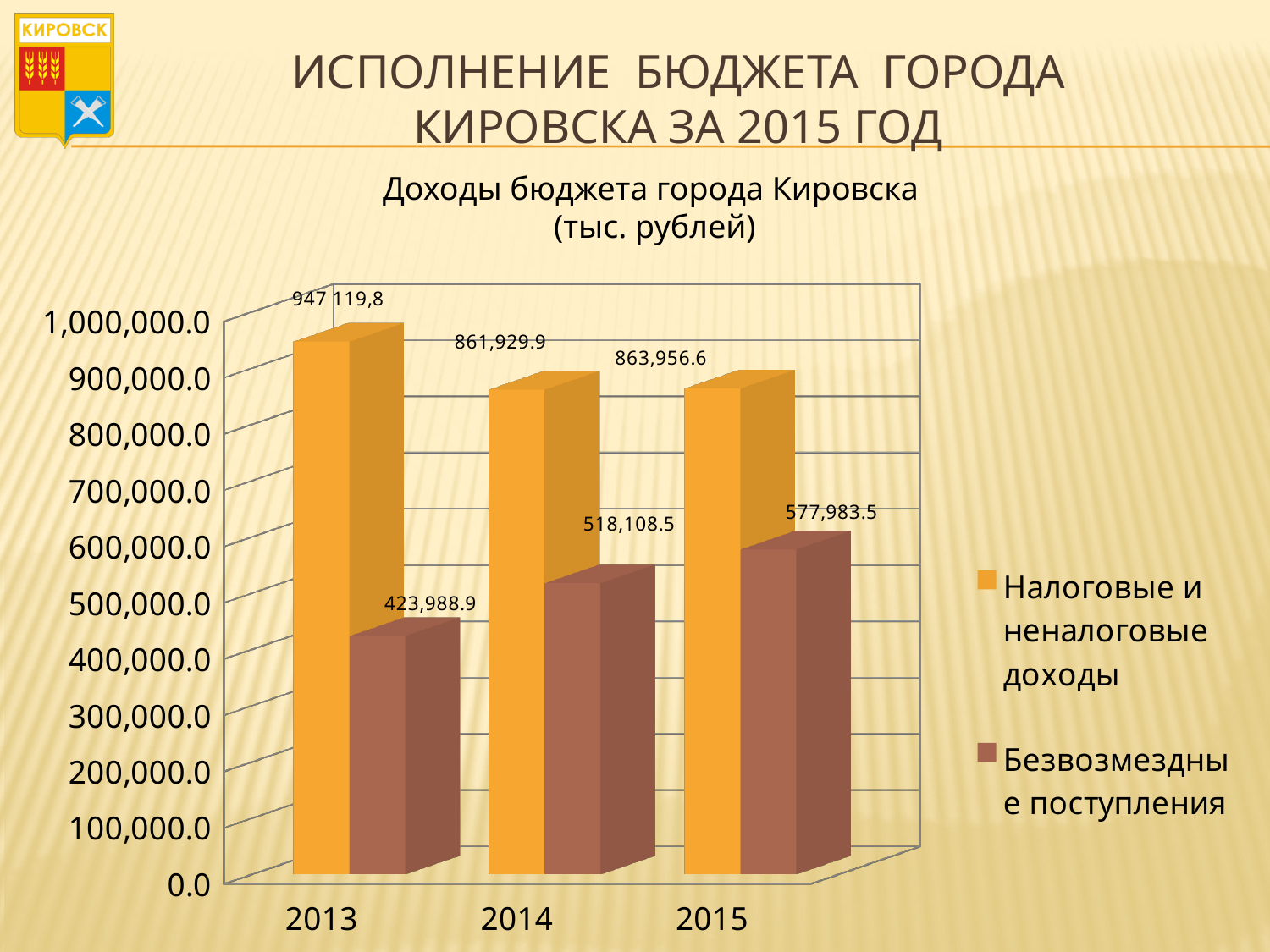
How many years are shown on the x axis? 3 What is the value of Безвозмездные поступления for 2015? 577,983.5 In which year were Налоговые и неналоговые доходы the highest? 2013 Which is larger in 2015: Налоговые и неналоговые доходы or Безвозмездные поступления? Налоговые и неналоговые доходы In which year were Безвозмездные поступления the lowest? 2013 What type of chart is shown on the slide? Bar chart What is the title of the chart? Доходы бюджета города Кировска (тыс. рублей) Do Безвозмездные поступления rise or fall from 2013 to 2015? Rise What is the value of Налоговые и неналоговые доходы for 2014? 861,929.9 What is the difference between Безвозмездные поступления in 2015 and 2014? 59,875.0 What is the value of Безвозмездные поступления for 2013? 423,988.9 How many series does the legend list? 2